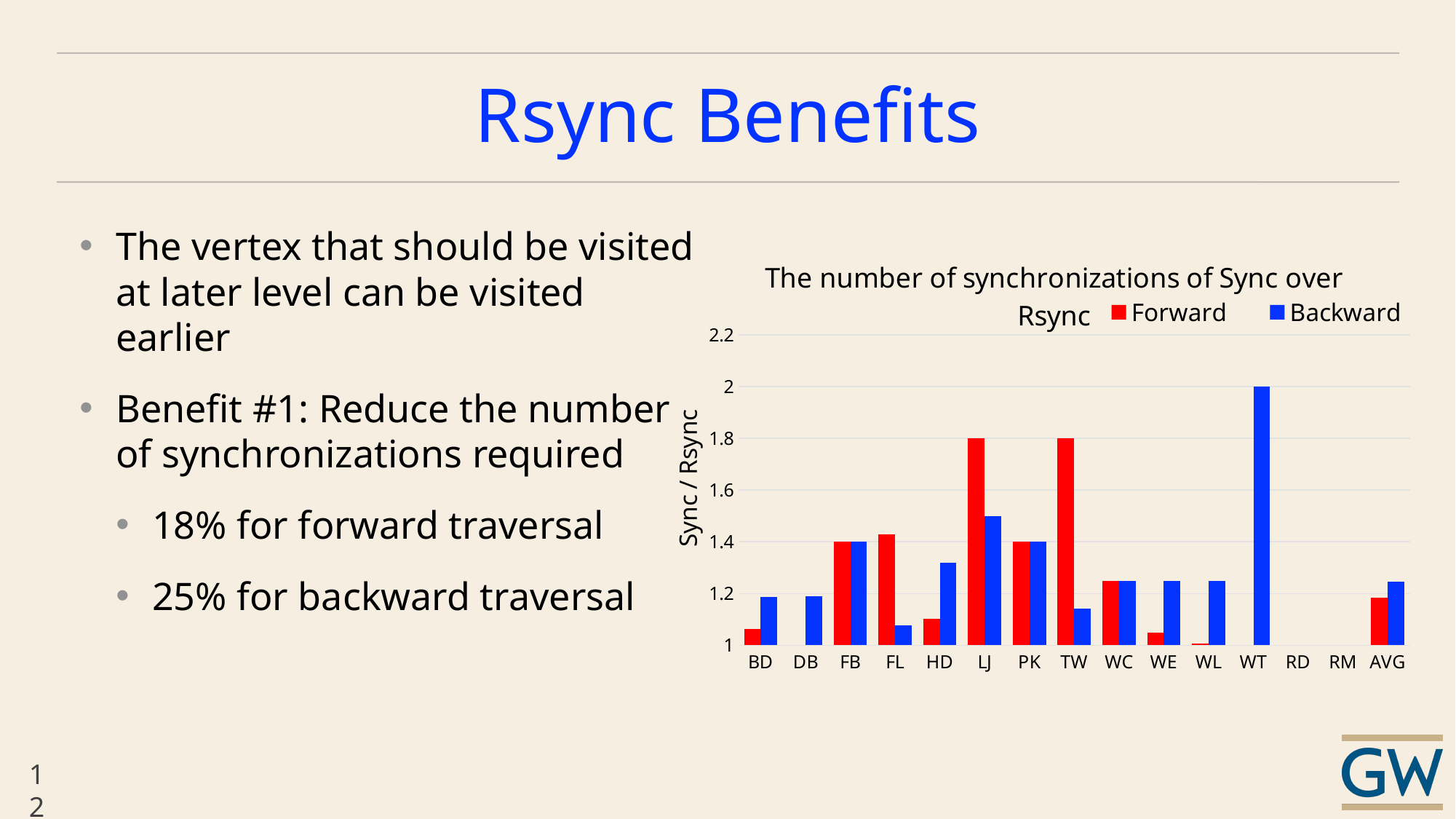
What is the Backward value for WT? 2 Which colour represents the Backward series in the chart? blue What kind of chart is shown on the slide? bar chart How many series does the chart legend list? 2 What is the label of the vertical axis of the chart? Sync / Rsync Which category has the highest Backward value? WT For HD, which is larger, the Forward or the Backward value? Backward Is the Backward value for HD greater or less than 1.4? less How many categories are shown along the x axis of the chart? 15 Is the Forward value for WE greater or less than 1.2? less For LJ, which is larger, the Forward or the Backward value? Forward What is the Forward value for LJ? 1.8